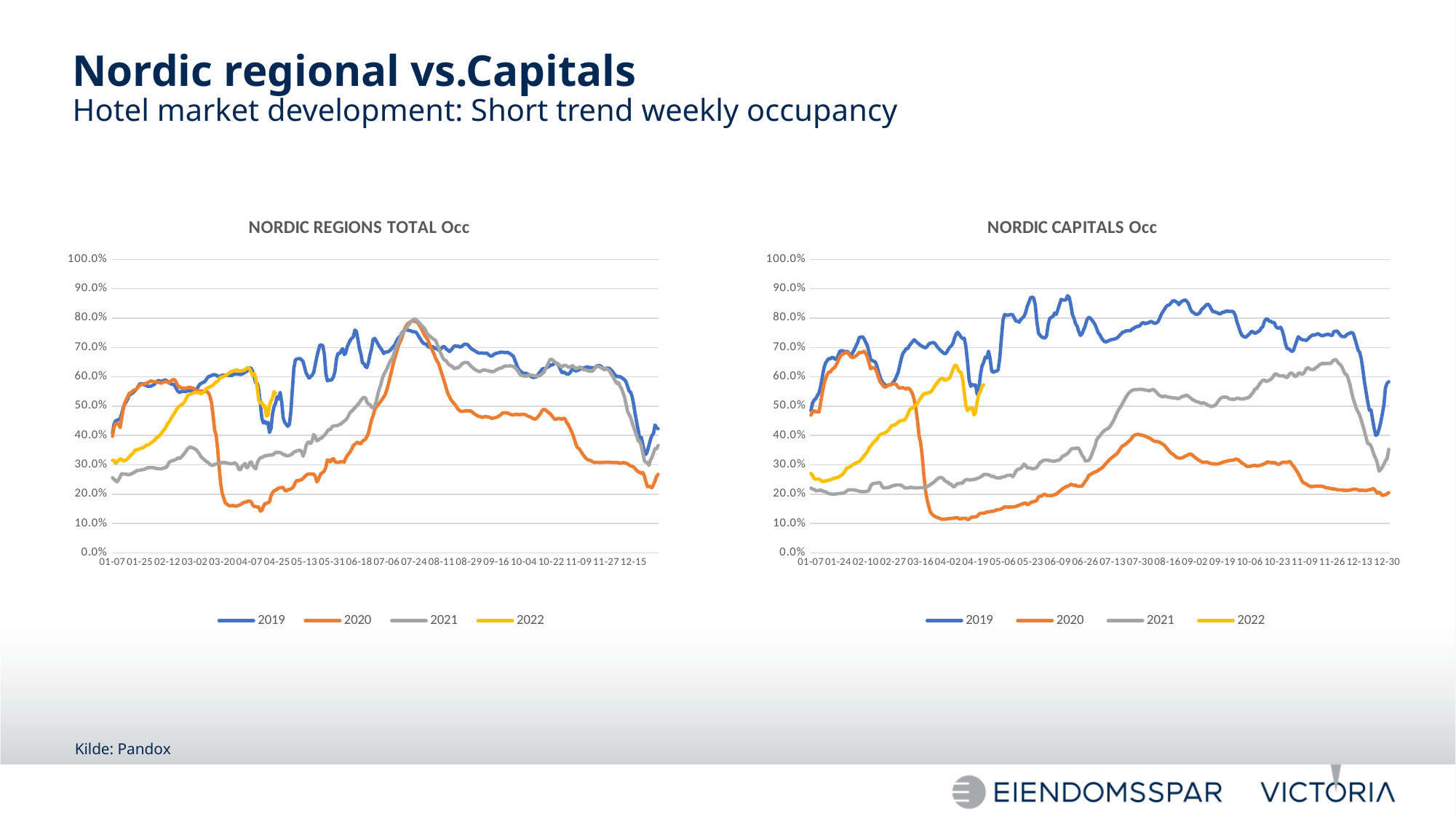
In the NORDIC CAPITALS Occ chart, does the 2020 line rise or fall between 03-16 and 04-02? fall In the NORDIC REGIONS TOTAL Occ chart, does the 2022 line rise or fall between 01-07 and 03-20? rise In the NORDIC CAPITALS Occ chart, is the highest value of the 2022 line greater or less than 50.0%? greater In the NORDIC CAPITALS Occ chart, is the peak of the 2019 line (around 06-09) greater or less than 80.0%? greater In the NORDIC CAPITALS Occ chart, which colour is used for the 2020 series? orange In the NORDIC REGIONS TOTAL Occ chart, is the lowest value of the 2020 line (around 04-07) greater or less than 20.0%? less In the NORDIC CAPITALS Occ chart, at 07-30, which series is higher: 2019 or 2020? 2019 Which years are listed in the legend of the NORDIC REGIONS TOTAL Occ chart? 2019, 2020, 2021, 2022 How many series does the legend of the NORDIC CAPITALS Occ chart list? 4 What kind of chart is the NORDIC REGIONS TOTAL Occ chart? line chart